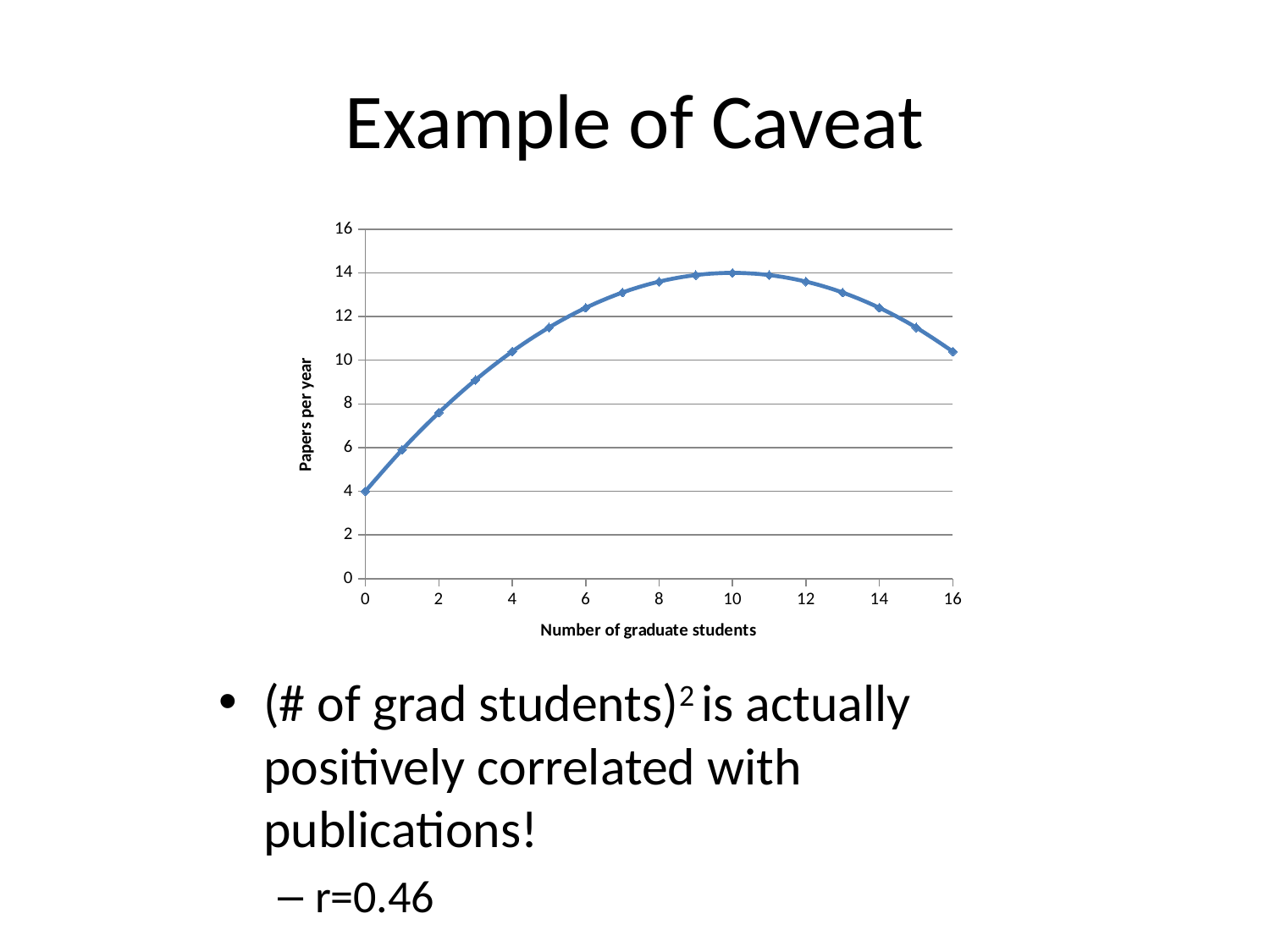
At which number of graduate students is papers per year highest? 10 What is the papers per year value when the number of graduate students is 0? 4 How many data points are plotted on the line? 17 What is the title of the y axis? Papers per year Which has more papers per year: 4 graduate students or 12 graduate students? 12 graduate students At which number of graduate students is papers per year lowest? 0 Is the papers per year value for 16 graduate students greater or less than 10? greater What kind of chart is shown on the slide? line chart What is the difference in papers per year between 10 graduate students and 0 graduate students? 10 What is the papers per year value when the number of graduate students is 10? 14 Do papers per year rise or fall as the number of graduate students increases from 10 to 16? fall What is the title of the x axis? Number of graduate students